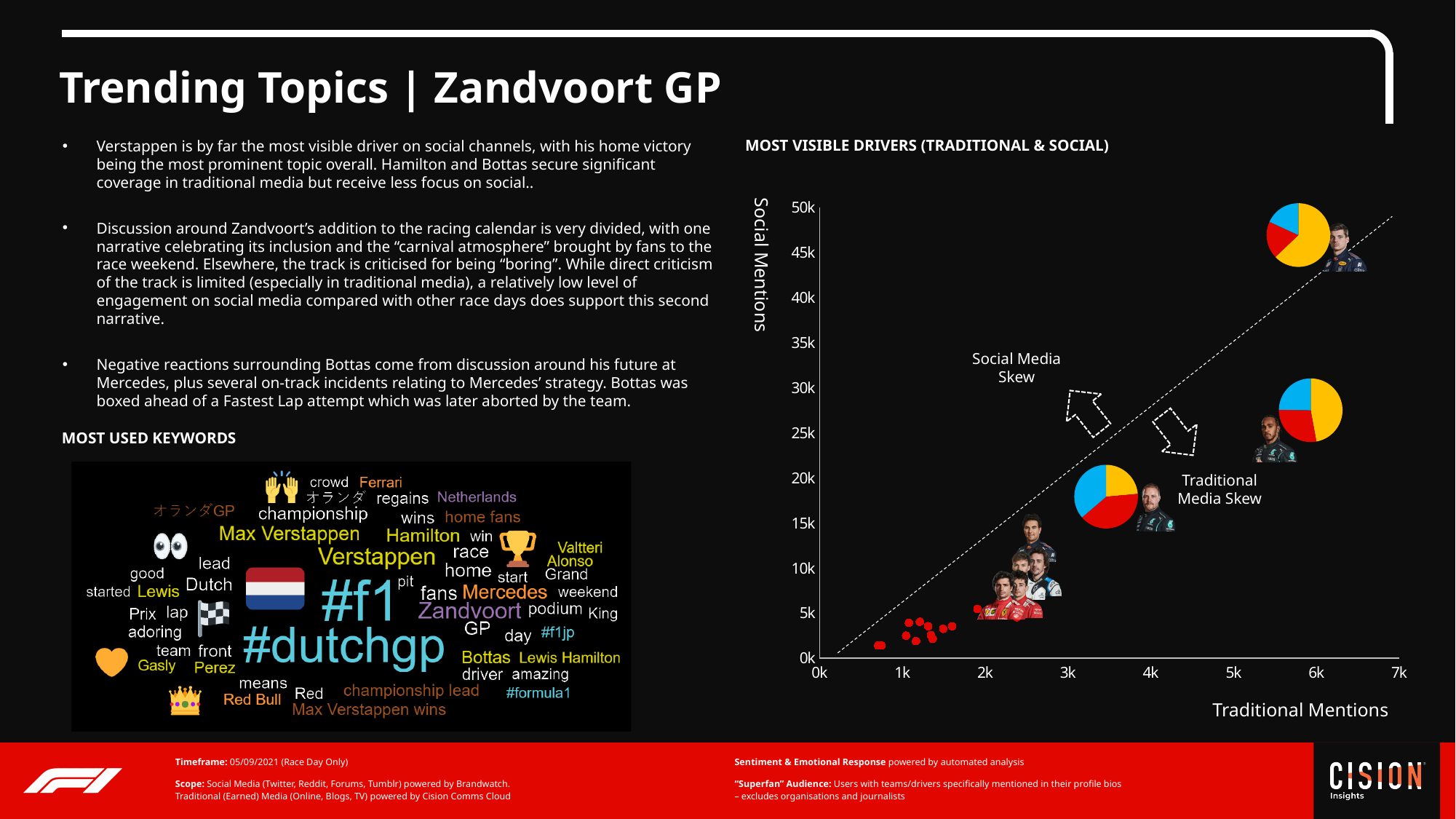
On the 'MOST VISIBLE DRIVERS' chart, is the traditional mentions value of the highest point greater or less than 5k? greater On the 'MOST VISIBLE DRIVERS' chart, is the social mentions value of the highest point greater or less than 40k? greater On the 'MOST VISIBLE DRIVERS' chart, what is the title of the horizontal axis? Traditional Mentions On the 'MOST VISIBLE DRIVERS' chart, are the small red dots clustered below 2k or above 2k traditional mentions? below 2k How many pie-chart markers are plotted on the 'MOST VISIBLE DRIVERS' chart? 3 On the 'MOST VISIBLE DRIVERS' chart, do social mentions generally rise or fall as traditional mentions increase? rise What kind of chart is 'MOST VISIBLE DRIVERS (TRADITIONAL & SOCIAL)'? Scatter chart On the 'MOST VISIBLE DRIVERS' chart, what are the two skew labels written beside the dashed diagonal line? Social Media Skew and Traditional Media Skew